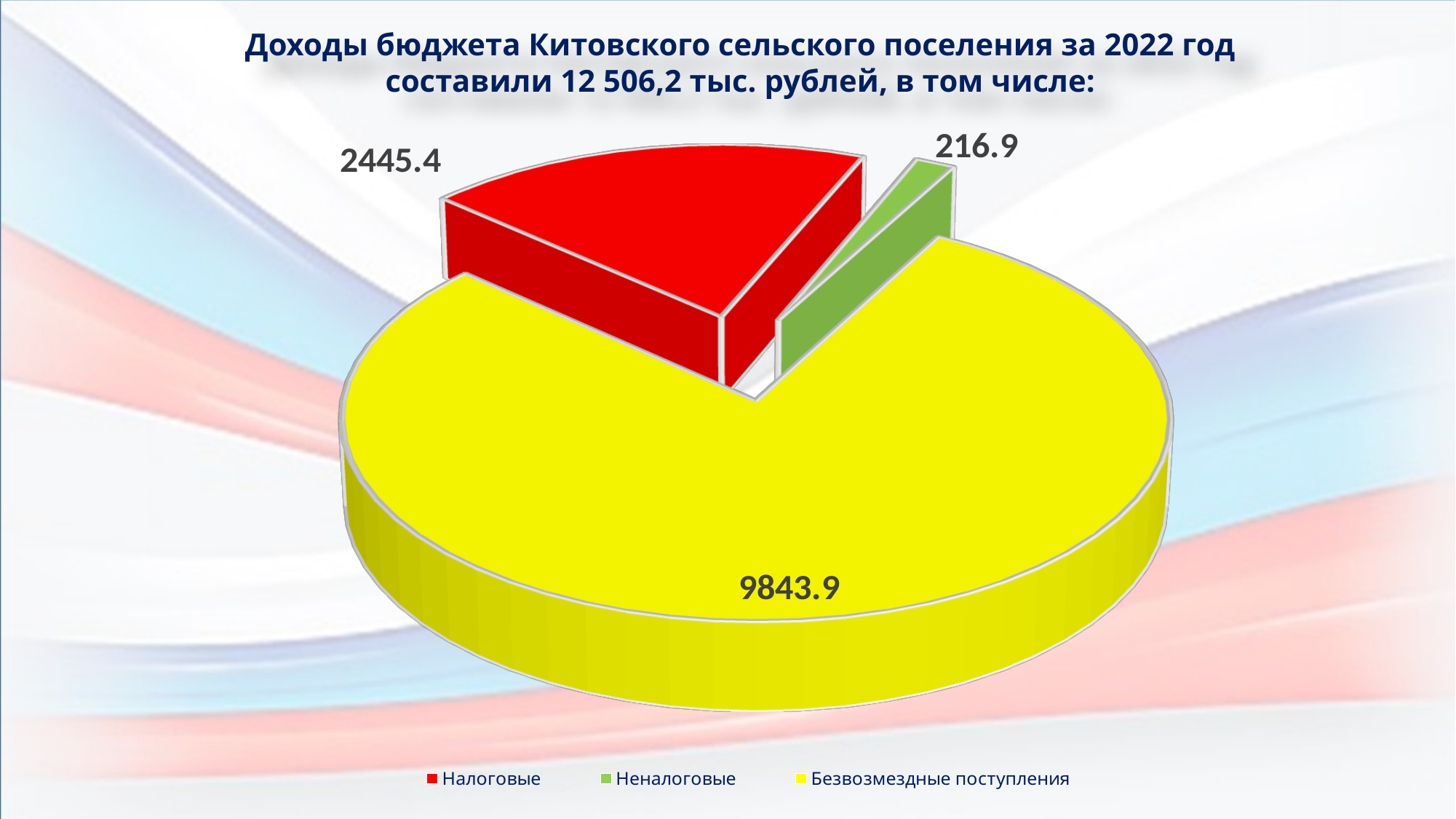
Which category has the largest slice of the pie? Безвозмездные поступления What colour is the slice for Безвозмездные поступления? Yellow What is the difference between the values for Налоговые and Неналоговые? 2228.5 How many categories does the pie chart have? 3 What is the total of all slices in the pie chart, as stated in the slide title? 12 506,2 тыс. рублей Which category has the smallest slice of the pie? Неналоговые What is the value for Налоговые? 2445.4 What is the value for Безвозмездные поступления? 9843.9 Which is larger, the value for Налоговые or the value for Неналоговые? Налоговые What kind of chart is shown on the slide? Pie chart What is the value for Неналоговые? 216.9 What is the difference between the values for Безвозмездные поступления and Налоговые? 7398.5